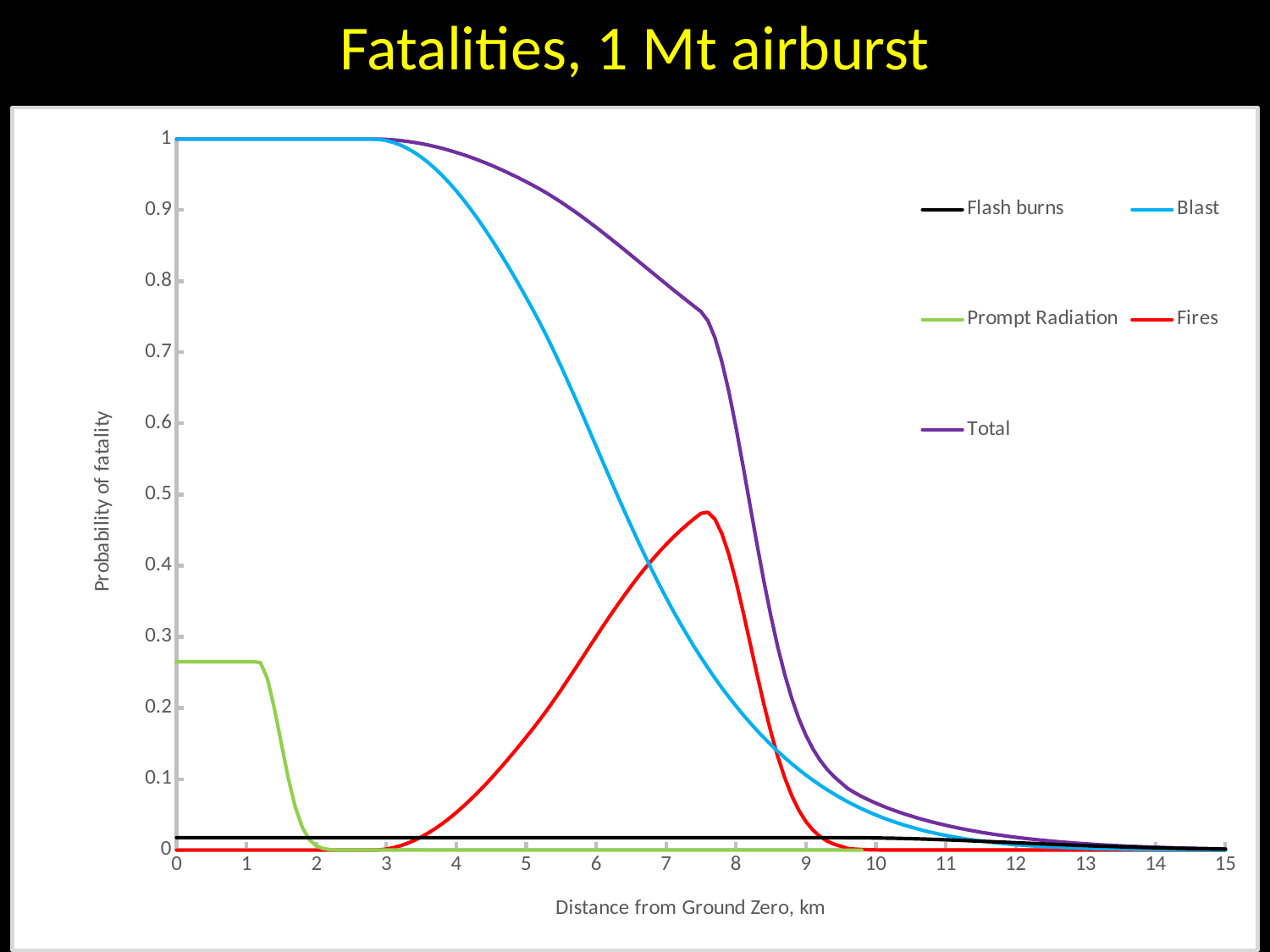
Does the Blast series rise or fall as distance increases from 3 km to 15 km? fall What is the title of the chart? Fatalities, 1 Mt airburst How many series does the legend list? 5 What kind of chart is shown on the slide? line chart Is the value of the Total series at 8 km greater or less than 0.5? greater Is the peak value of the Fires series greater or less than 0.5? less What is the value of the Fires series at 0 km? 0 What is the value of the Blast series at 0 km? 1 Is the value of the Prompt Radiation series at 0 km greater or less than 0.2? greater At 5 km, which series has the larger value, Blast or Fires? Blast Which series has the lowest peak value across the whole chart? Flash burns What is the label of the x axis? Distance from Ground Zero, km